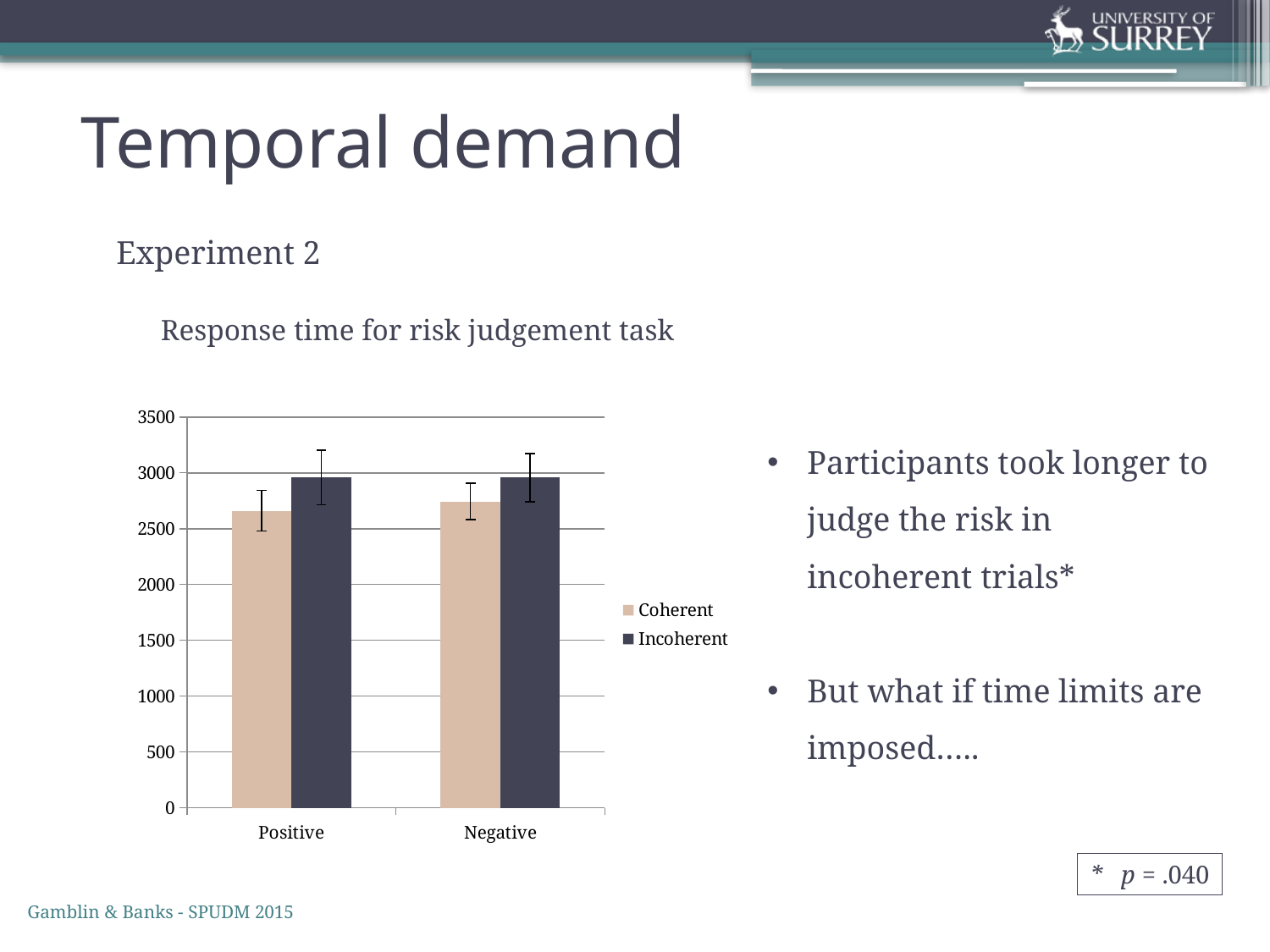
For the Positive category, which series has the larger value, Coherent or Incoherent? Incoherent Which bar in the chart has the lowest value? Coherent for Positive Is the Incoherent value for Positive greater or less than 2500? greater For the Negative category, which series has the larger value, Coherent or Incoherent? Incoherent How many categories are shown on the x axis of the chart? 2 Is the Coherent value for Negative greater or less than 3000? less What are the two series named in the chart's legend? Coherent and Incoherent What kind of chart is shown on the slide? bar chart Is the Coherent value for Positive greater or less than 2500? greater What is the title of the chart? Response time for risk judgement task How many series does the chart's legend list? 2